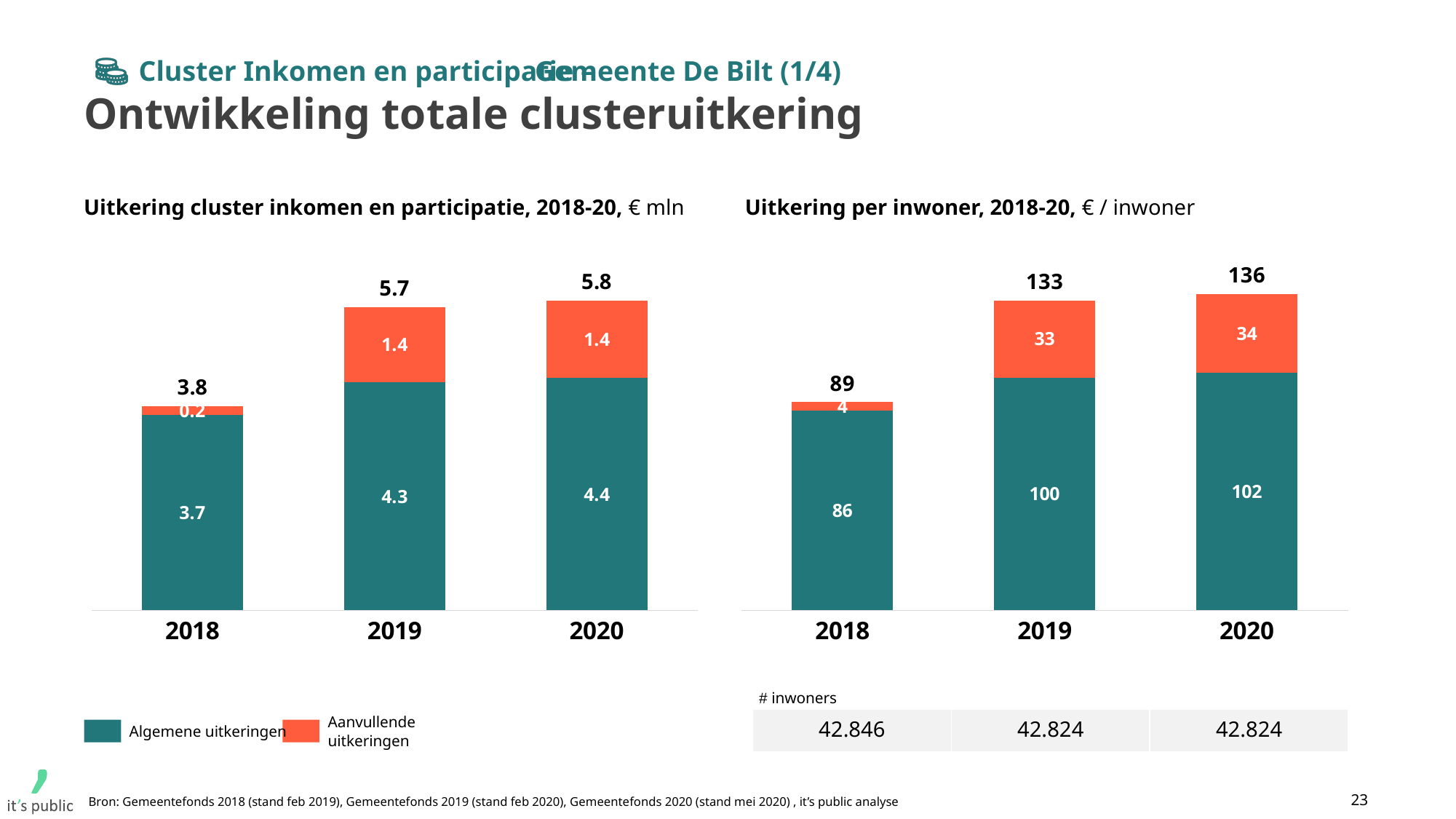
In the left chart (Uitkering cluster inkomen en participatie), what is the value of Algemene uitkeringen for 2019? 4.3 In the left chart (Uitkering cluster inkomen en participatie), which year has the lowest total? 2018 In the right chart (Uitkering per inwoner), what is the difference between the totals for 2019 and 2018? 44 What kind of chart is the left chart (Uitkering cluster inkomen en participatie)? Stacked bar chart In the right chart (Uitkering per inwoner), which year has the highest total? 2020 How many series does the legend list for the charts? 2 In the right chart (Uitkering per inwoner), what is the value of Algemene uitkeringen for 2020? 102 In the left chart (Uitkering cluster inkomen en participatie), what is the total printed above the 2020 bar? 5.8 In the left chart (Uitkering cluster inkomen en participatie), what is the difference between the Algemene uitkeringen values for 2020 and 2018? 0.7 In the right chart (Uitkering per inwoner), is the Aanvullende uitkeringen value larger in 2020 or in 2018? 2020 In the right chart (Uitkering per inwoner), what is the value of Aanvullende uitkeringen for 2019? 33 In the left chart (Uitkering cluster inkomen en participatie), what is the value of Aanvullende uitkeringen for 2018? 0.2